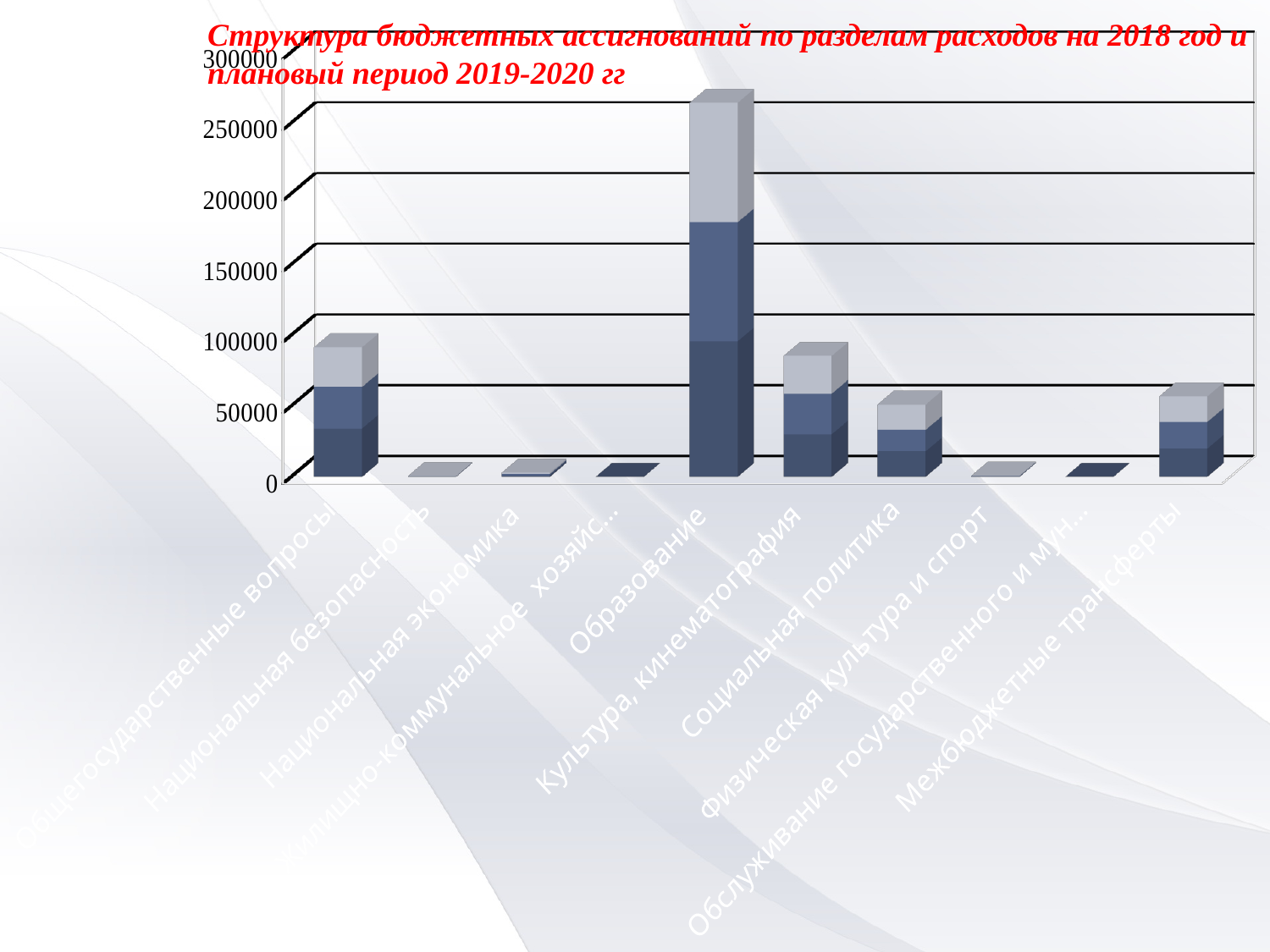
Which has the larger total bar, Национальная экономика or Межбюджетные трансферты? Межбюджетные трансферты What is the title of the chart? Структура бюджетных ассигнований по разделам расходов на 2018 год и плановый период 2019-2020 гг Which has the larger total bar, Образование or Культура, кинематография? Образование Which category has the highest total bar? Образование How many stacked segments make up the Образование bar? 3 Is the total value for Образование greater or less than 250000? greater Is the total value for Культура, кинематография greater or less than 150000? less What kind of chart is shown on the slide? stacked bar chart How many expenditure categories are shown along the x axis? 10 Is the total value for Национальная безопасность greater or less than 50000? less Which has the larger total bar, Общегосударственные вопросы or Социальная политика? Общегосударственные вопросы